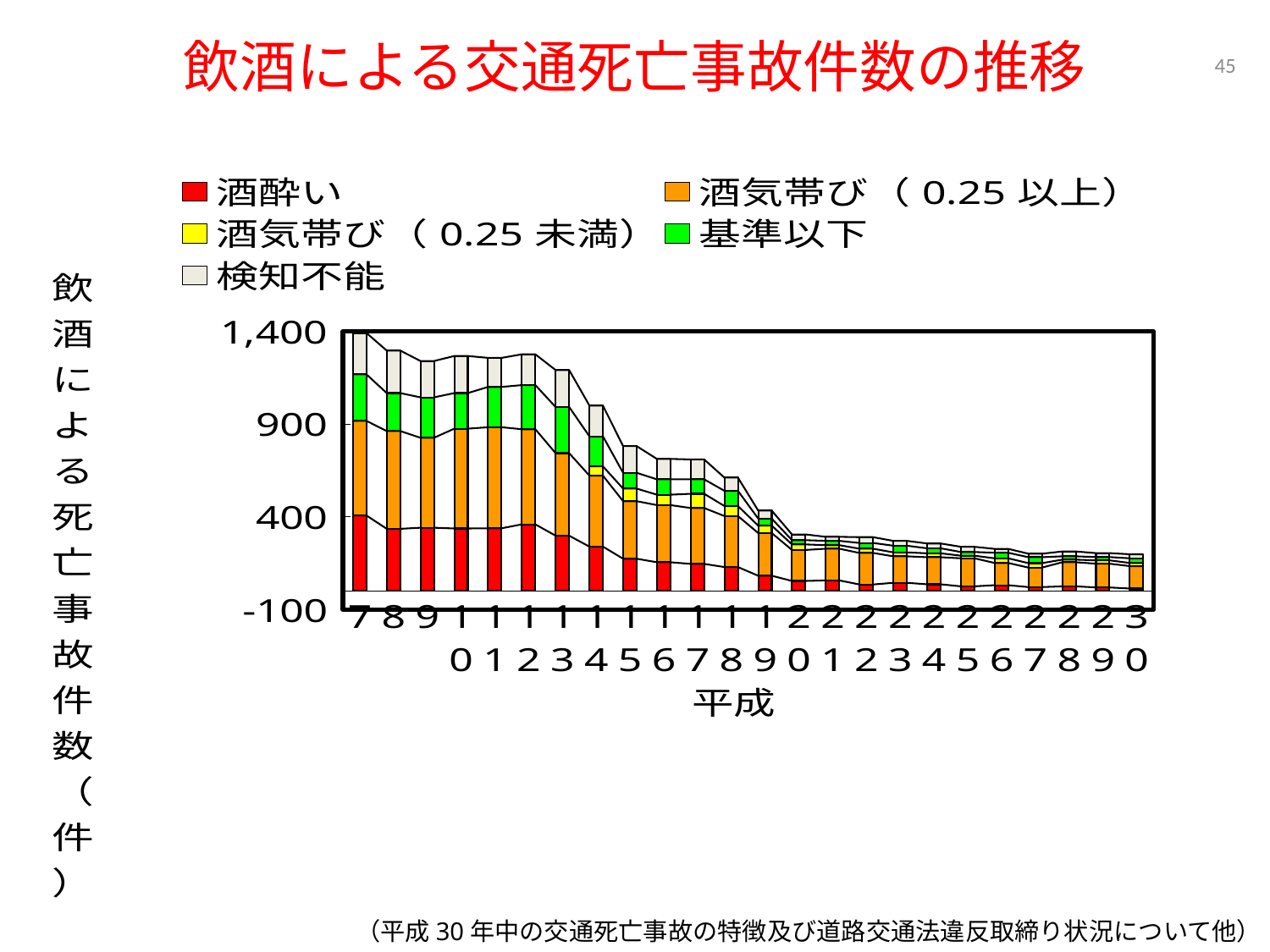
How many series does the legend list? 5 What is the title of the chart? 飲酒による交通死亡事故件数の推移 Do the total numbers of fatal accidents rise or fall from 平成7 to 平成30? fall Is the total value for 平成30 greater or less than 400? less Which is larger, the total for 平成7 or the total for 平成30? 平成7 Is the total value for 平成15 greater or less than 400? greater How many years (bars) are plotted along the x axis? 24 Is the 酒酔い value for 平成7 greater or less than 900? less Which year has the highest total number of fatal accidents? 平成7 Which legend entry is shown in red? 酒酔い What kind of chart is shown on the slide? stacked bar chart